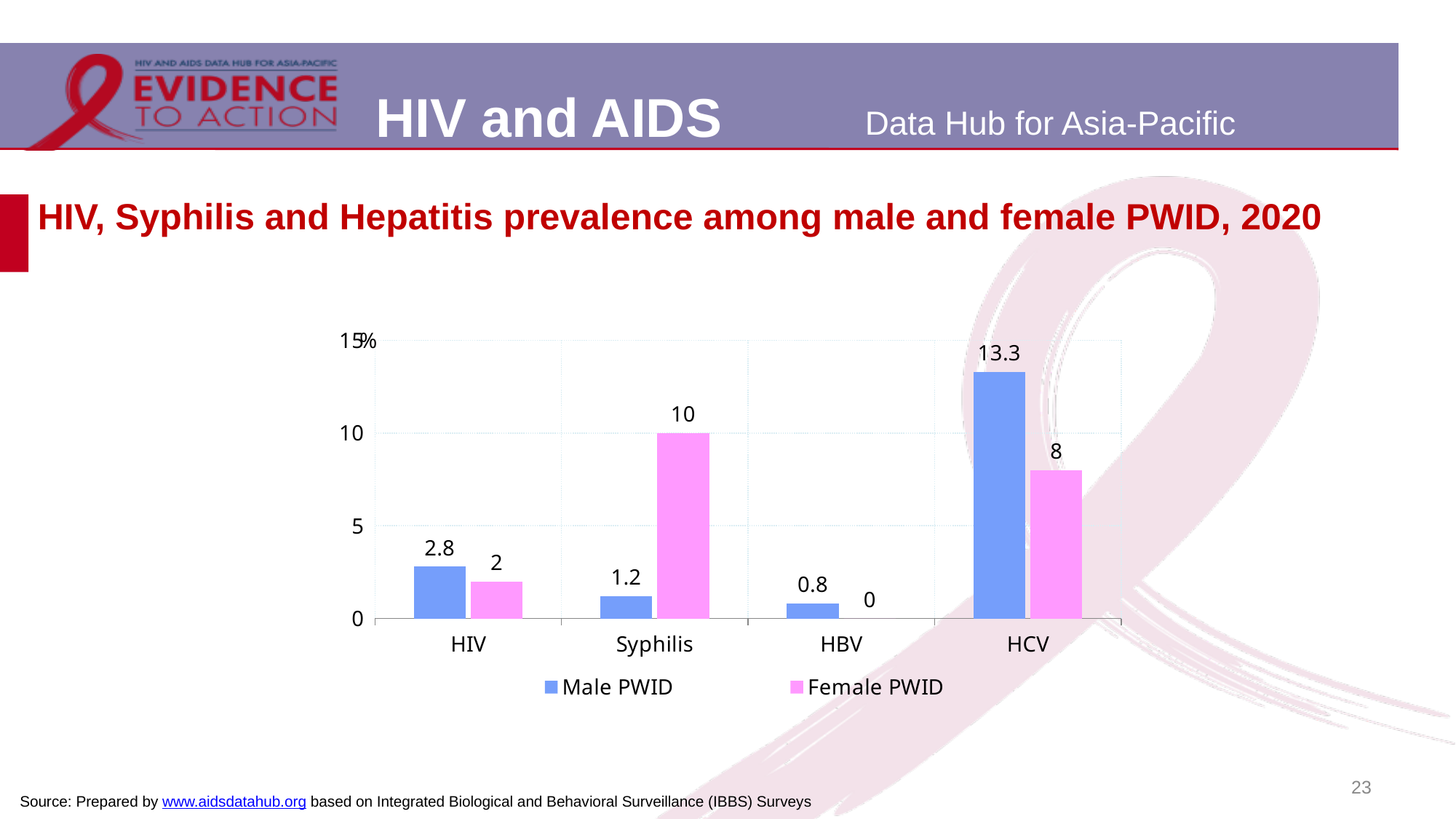
How many categories are shown on the x axis? 4 Which category has the highest value for Male PWID? HCV Which category has the lowest value for Female PWID? HBV What is the value for Male PWID in the HBV category? 0.8 What kind of chart is shown on the slide? Bar chart What is the value for Female PWID in the HIV category? 2 In the Syphilis category, which is larger: the Male PWID value or the Female PWID value? Female PWID Is the Male PWID value for HCV greater or less than 10? greater How many series does the legend list? 2 What is the value for Male PWID in the HCV category? 13.3 What is the difference between the Male PWID and Female PWID values in the HCV category? 5.3 What is the value for Female PWID in the Syphilis category? 10